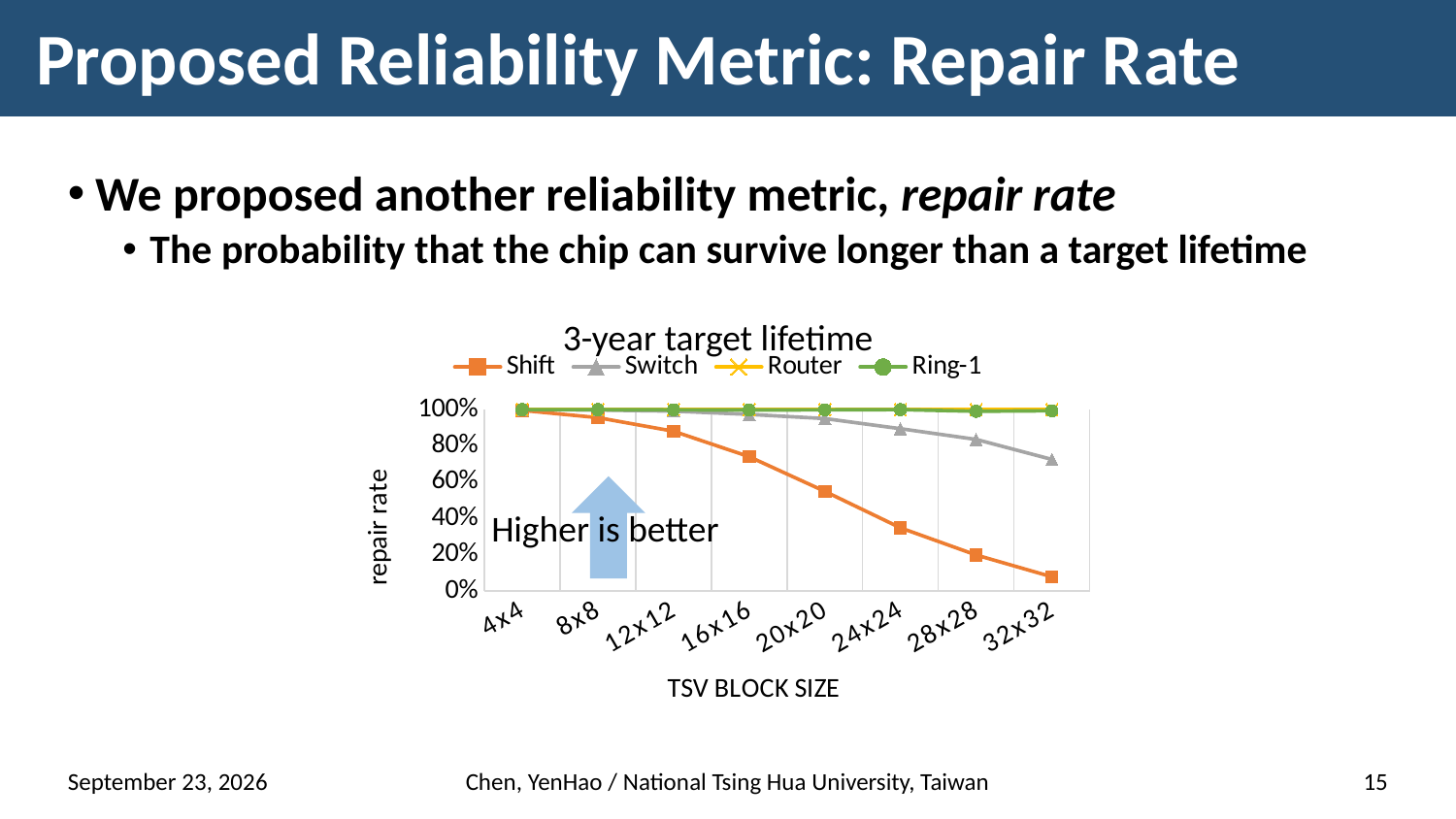
Which series has the lowest repair rate at 32x32? Shift How many series does the chart legend list? 4 What is the title of the chart? 3-year target lifetime Is the repair rate for Shift at 20x20 greater or less than 40%? greater What is the label of the y axis? repair rate Does the repair rate for Shift rise or fall as the TSV block size increases? fall Is the repair rate for Shift at 16x16 greater or less than 80%? less What kind of chart is shown on the slide? line chart How many TSV block sizes are plotted along the x axis? 8 Is the repair rate for Shift at 32x32 greater or less than 20%? less At 32x32, which series has a higher repair rate, Shift or Switch? Switch